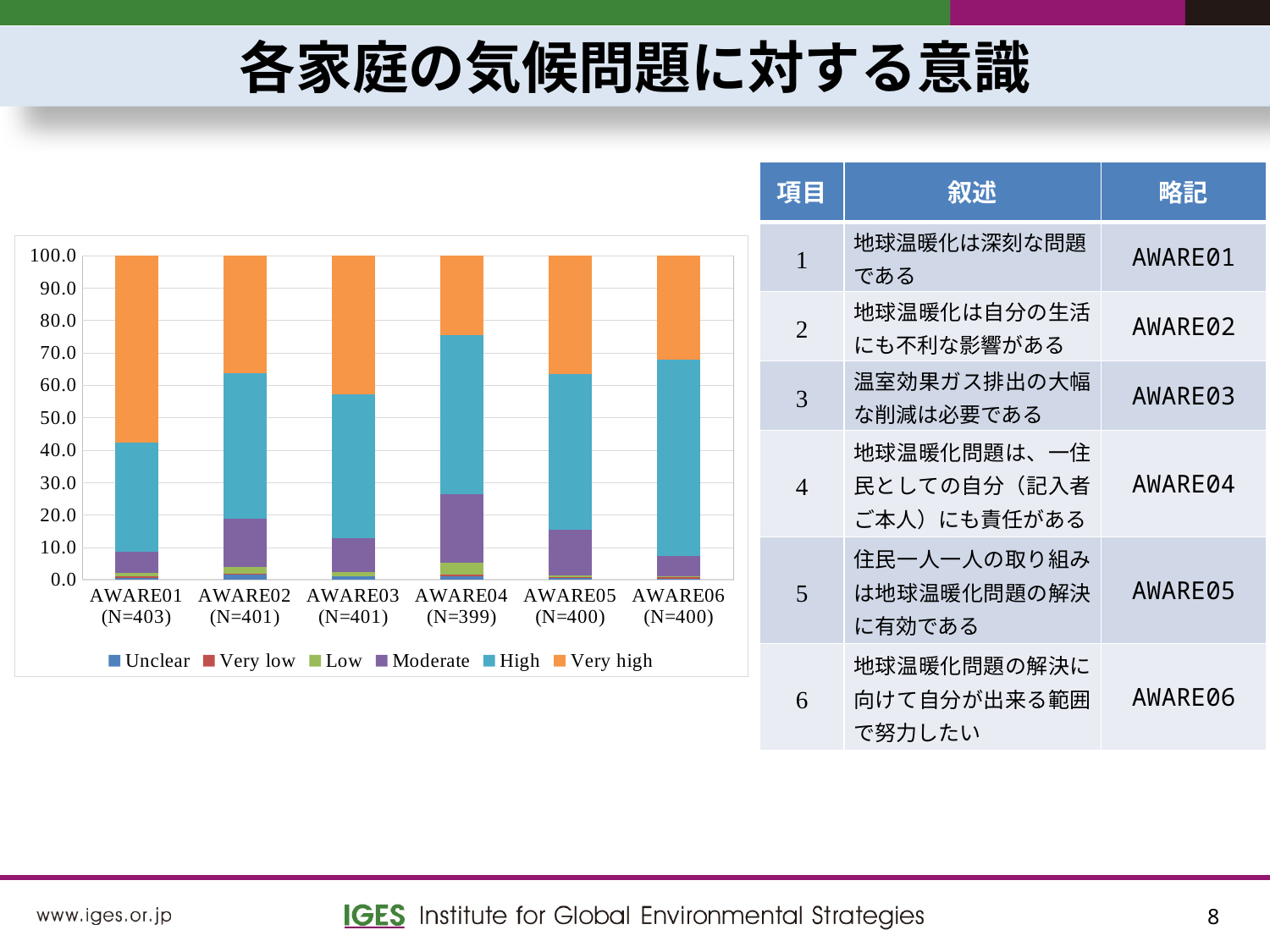
Is the Moderate value for AWARE06 greater or less than 10? less What are the series names listed in the chart legend? Unclear, Very low, Low, Moderate, High, Very high What is the sample size N shown for AWARE04 on the x axis? 399 Which has the larger Moderate segment, AWARE04 or AWARE02? AWARE04 Is the Very high value for AWARE01 greater or less than 50? greater Which category has the largest High segment? AWARE06 What is the total height of each stacked bar on the y axis? 100.0 Which category has the smallest High segment? AWARE01 What kind of chart is shown on the slide? stacked bar chart How many categories (AWARE items) are plotted on the x axis of the chart? 6 How many series does the chart legend list? 6 Which category has the largest Very high segment? AWARE01